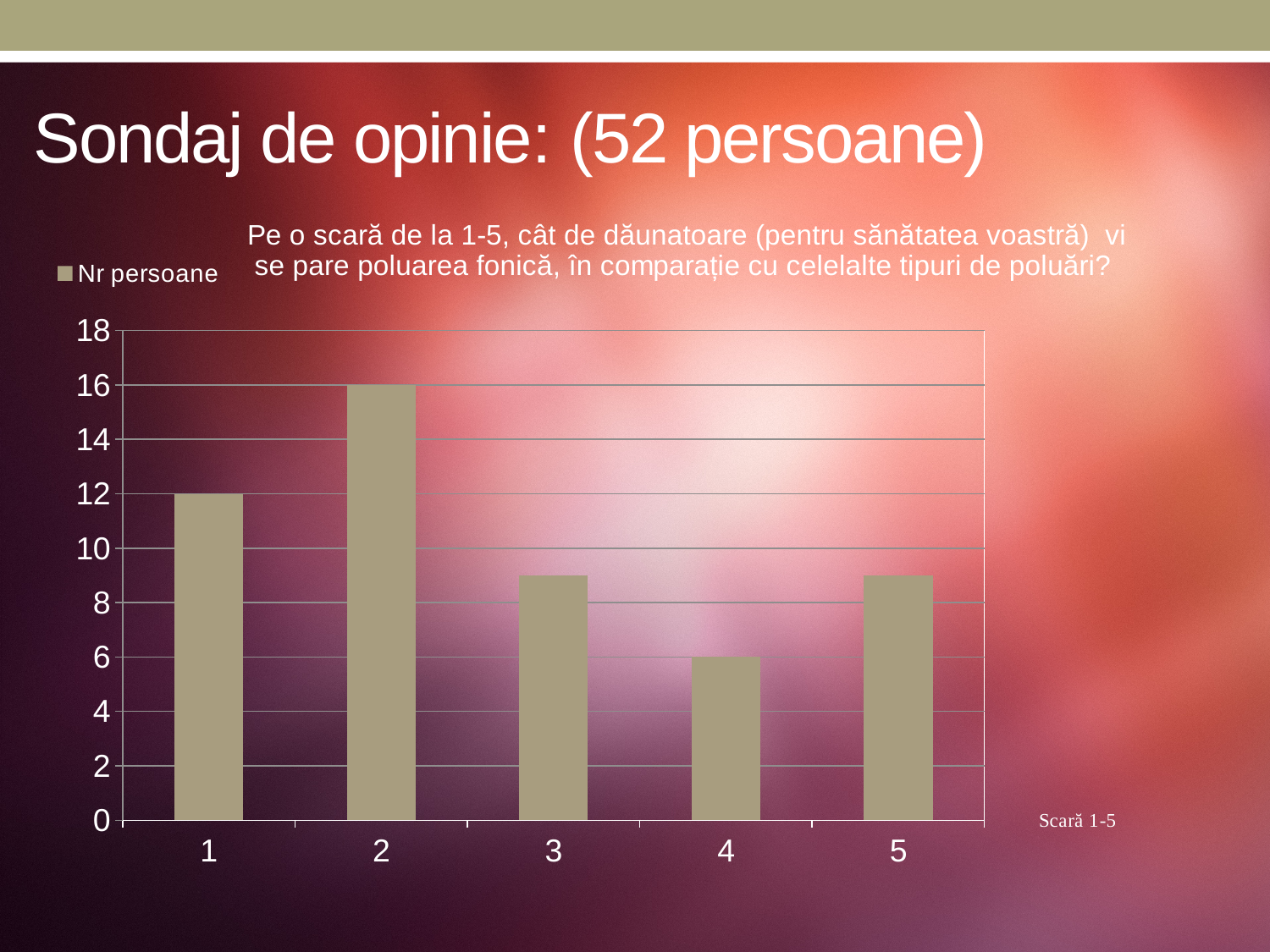
Is the value for category 3 greater or less than 8? greater What is the value for category 4? 6 Which is larger, the value for category 1 or the value for category 2? 2 Which category has the lowest value? 4 Is the value for category 5 greater or less than 10? less What kind of chart is shown on the slide? bar chart What is the difference between the values for category 1 and category 4? 6 What is the value for category 2? 16 How many categories are shown on the x axis? 5 Which category has the highest value? 2 What is the difference between the values for category 2 and category 1? 4 What is the value for category 1? 12